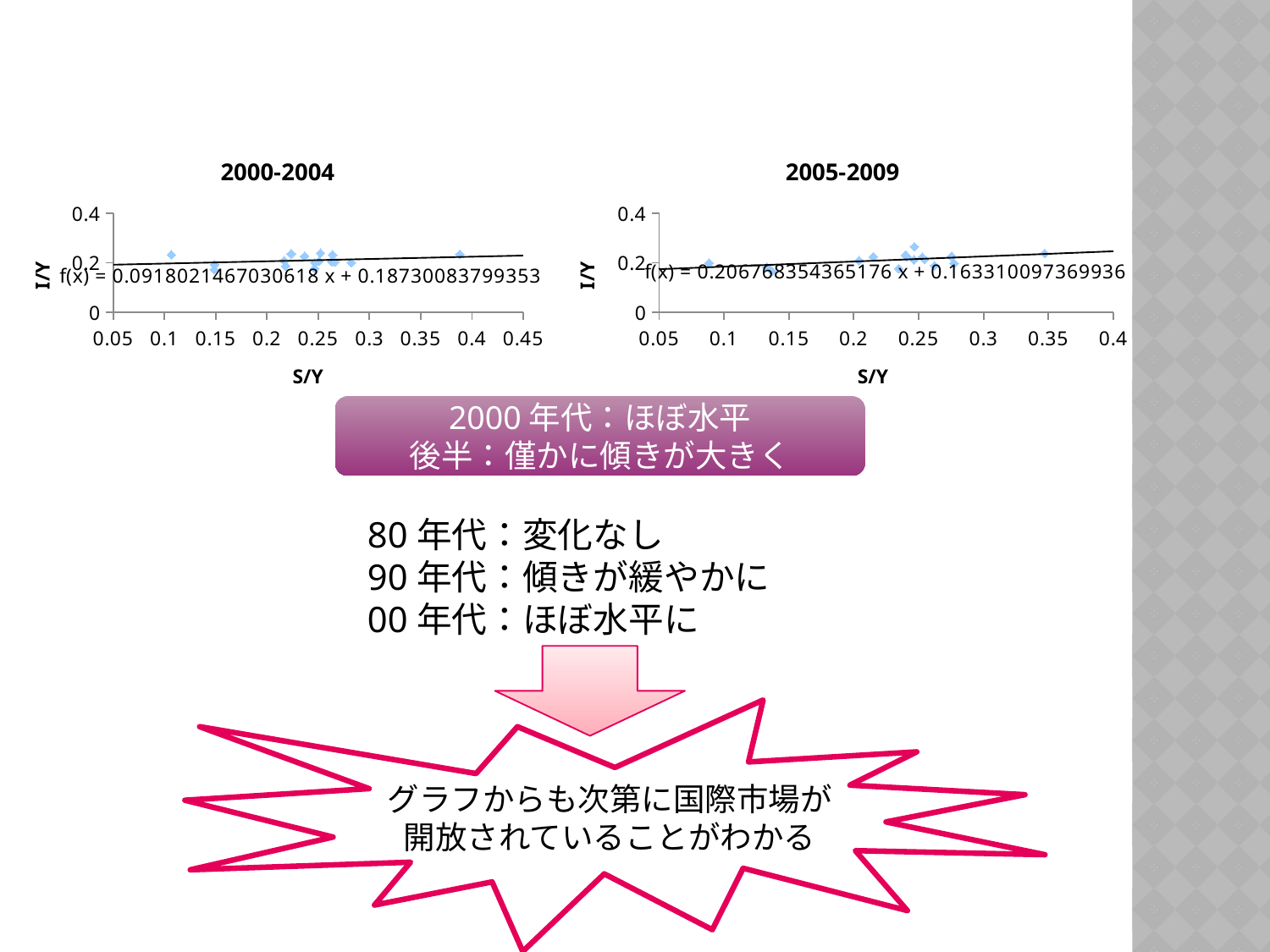
In the 2005-2009 chart, what is the trendline equation printed on the chart? f(x) = 0.206768354365176 x + 0.163310097369936 In the 2000-2004 chart, does the trendline rise or fall as S/Y increases? rise In the 2000-2004 chart, what is the trendline equation printed on the chart? f(x) = 0.0918021467030618 x + 0.18730083799353 What kind of chart is the 2000-2004 chart? scatter chart What is the title of the chart on the right side of the slide? 2005-2009 In the 2005-2009 chart, what is the slope of the trendline? 0.206768354365176 Which chart has the larger trendline slope, 2000-2004 or 2005-2009? 2005-2009 In the 2005-2009 chart, what is the largest value shown on the x-axis? 0.4 In the 2000-2004 chart, what is the intercept of the trendline? 0.18730083799353 What is the x-axis label of the 2005-2009 chart? S/Y In the 2000-2004 chart, what is the maximum value shown on the y-axis? 0.4 In the 2000-2004 chart, what is the largest value shown on the x-axis? 0.45